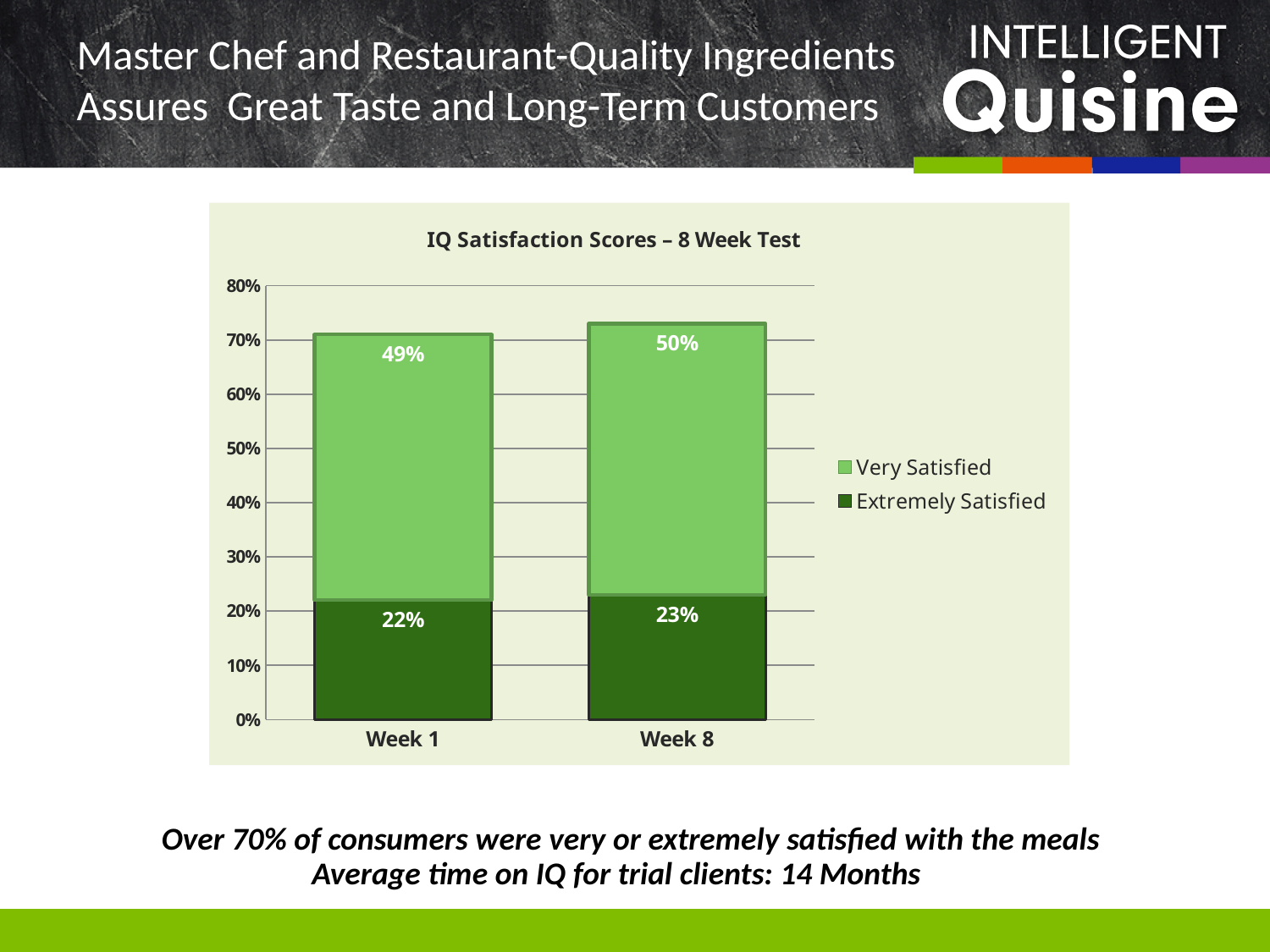
Which is larger, the Extremely Satisfied value for Week 1 or for Week 8? Week 8 What is the title of the chart? IQ Satisfaction Scores – 8 Week Test What is the Very Satisfied value for Week 1? 49% What is the Very Satisfied value for Week 8? 50% What kind of chart is shown on the slide? Stacked bar chart How many series does the legend list? 2 What is the total of the stacked bar for Week 1? 71% What is the difference between the Very Satisfied values for Week 8 and Week 1? 1% What is the Extremely Satisfied value for Week 8? 23% What is the Extremely Satisfied value for Week 1? 22% How many categories are shown on the x axis? 2 What is the total of the stacked bar for Week 8? 73%